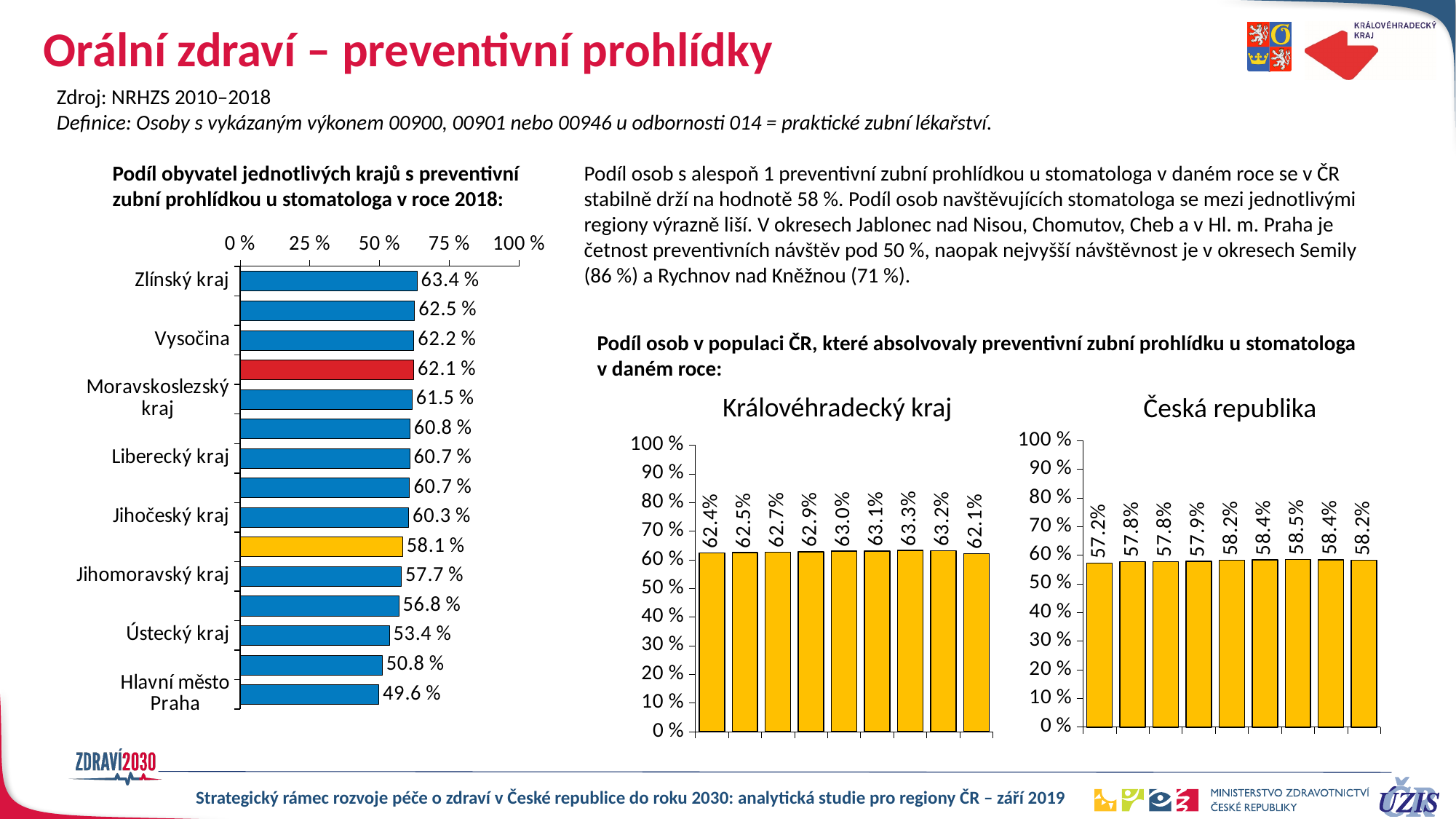
In the Královéhradecký kraj chart, what is the highest value shown? 63.3% In the left chart, what is the value for Hlavní město Praha? 49.6 % In the left chart (Podíl obyvatel jednotlivých krajů s preventivní zubní prohlídkou u stomatologa v roce 2018), what is the value for Zlínský kraj? 63.4 % In the left chart, which labelled region has the highest share? Zlínský kraj In the Královéhradecký kraj chart, how many bars are plotted? 9 In the Česká republika chart, what is the lowest value shown? 57.2% How many bars does the left chart contain? 15 What type of chart is the left chart showing regions in 2018? bar chart In the left chart, which labelled region has the lowest share? Hlavní město Praha In the left chart, which is larger: the value for Liberecký kraj or for Ústecký kraj? Liberecký kraj In the left chart, what is the difference between the values for Zlínský kraj and Hlavní město Praha? 13.8 % In the left chart, what is the value for Ústecký kraj? 53.4 %